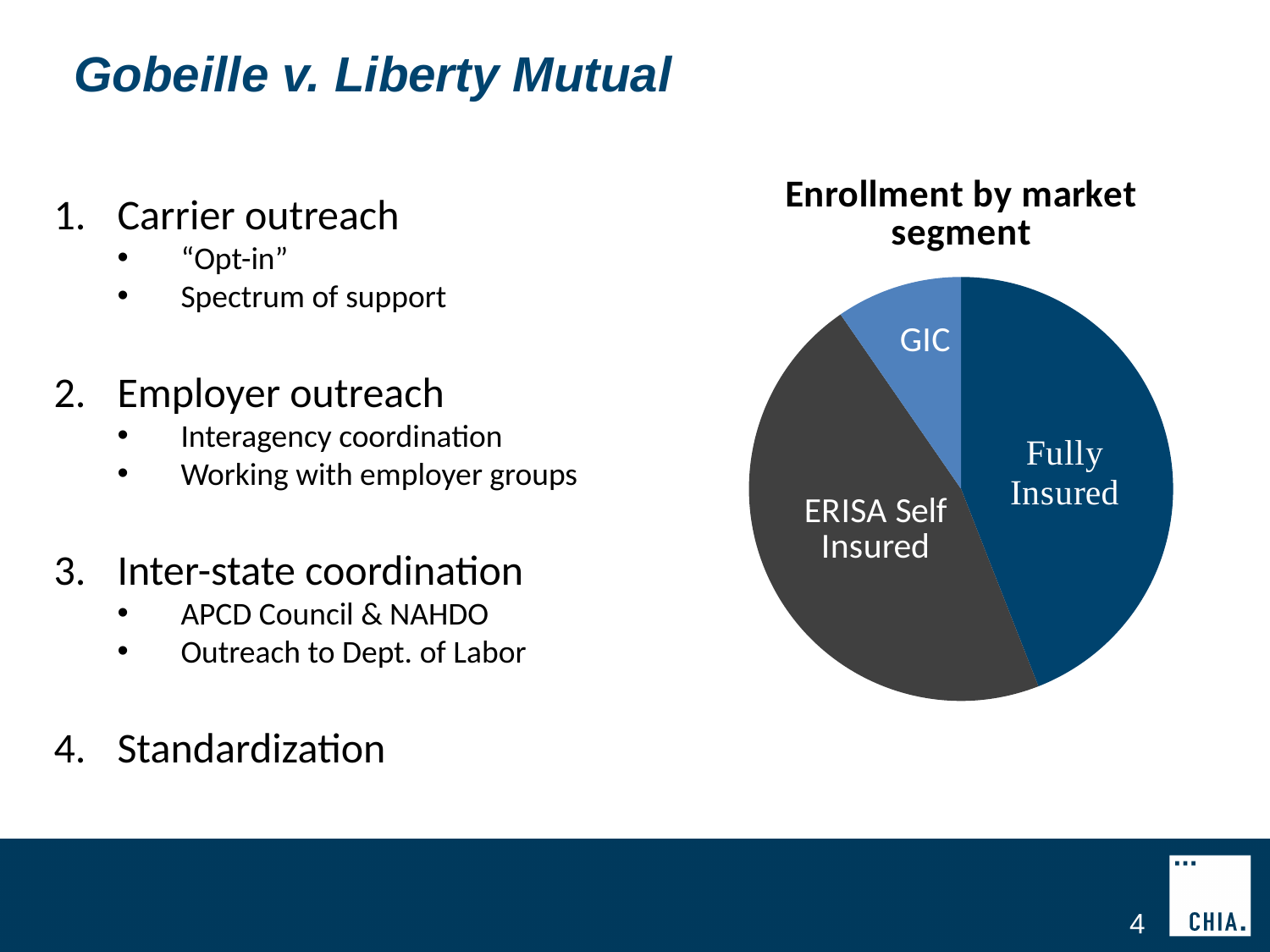
What kind of chart is shown on the slide? Pie chart Which market segment has the smallest share of enrollment in the pie chart? GIC What are the names of the three segments shown in the pie chart? Fully Insured, ERISA Self Insured, GIC Which slice is smaller in the pie chart, GIC or Fully Insured? GIC How many slices does the pie chart have? 3 Which slice is larger in the pie chart, GIC or ERISA Self Insured? ERISA Self Insured What is the title of the chart on the slide? Enrollment by market segment What colour is the ERISA Self Insured slice in the pie chart? Dark gray